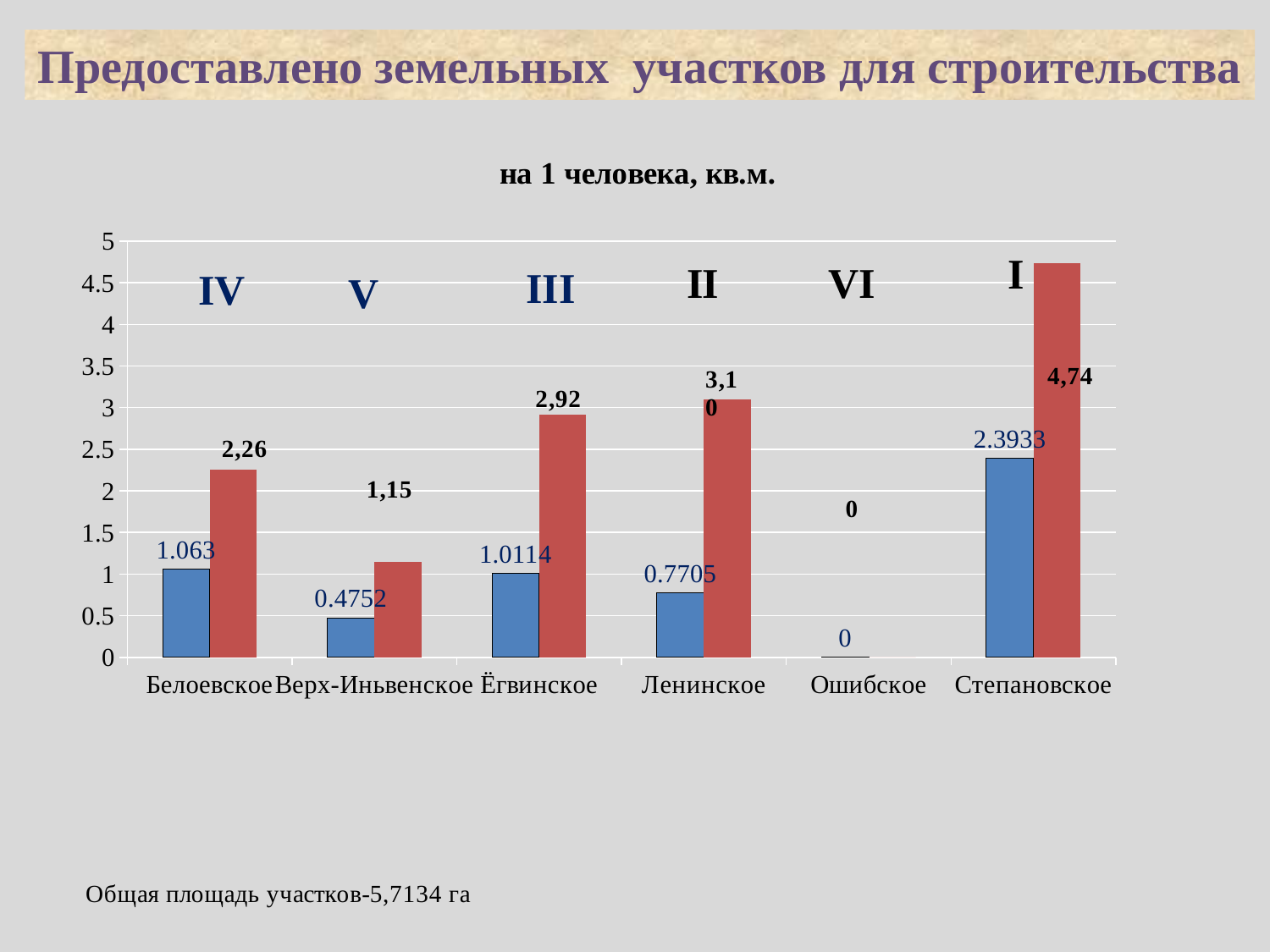
What type of chart is shown on the slide? bar chart What is the value of the red bar for Ленинское? 3,1 Which is larger, the red bar for Ёгвинское or the red bar for Белоевское? Ёгвинское What is the subtitle shown above the chart? на 1 человека, кв.м. What is the difference between the red bar values for Степановское and Ленинское? 1,64 What is the value of the red bar for Степановское? 4,74 Which category has the lowest blue bar? Ошибское Is the blue bar for Степановское greater or less than 2? greater How many categories are shown on the x axis of the chart? 6 What is the value of the blue bar for Верх-Иньвенское? 0.4752 What is the value of the blue bar for Белоевское? 1.063 Which category has the highest red bar? Степановское